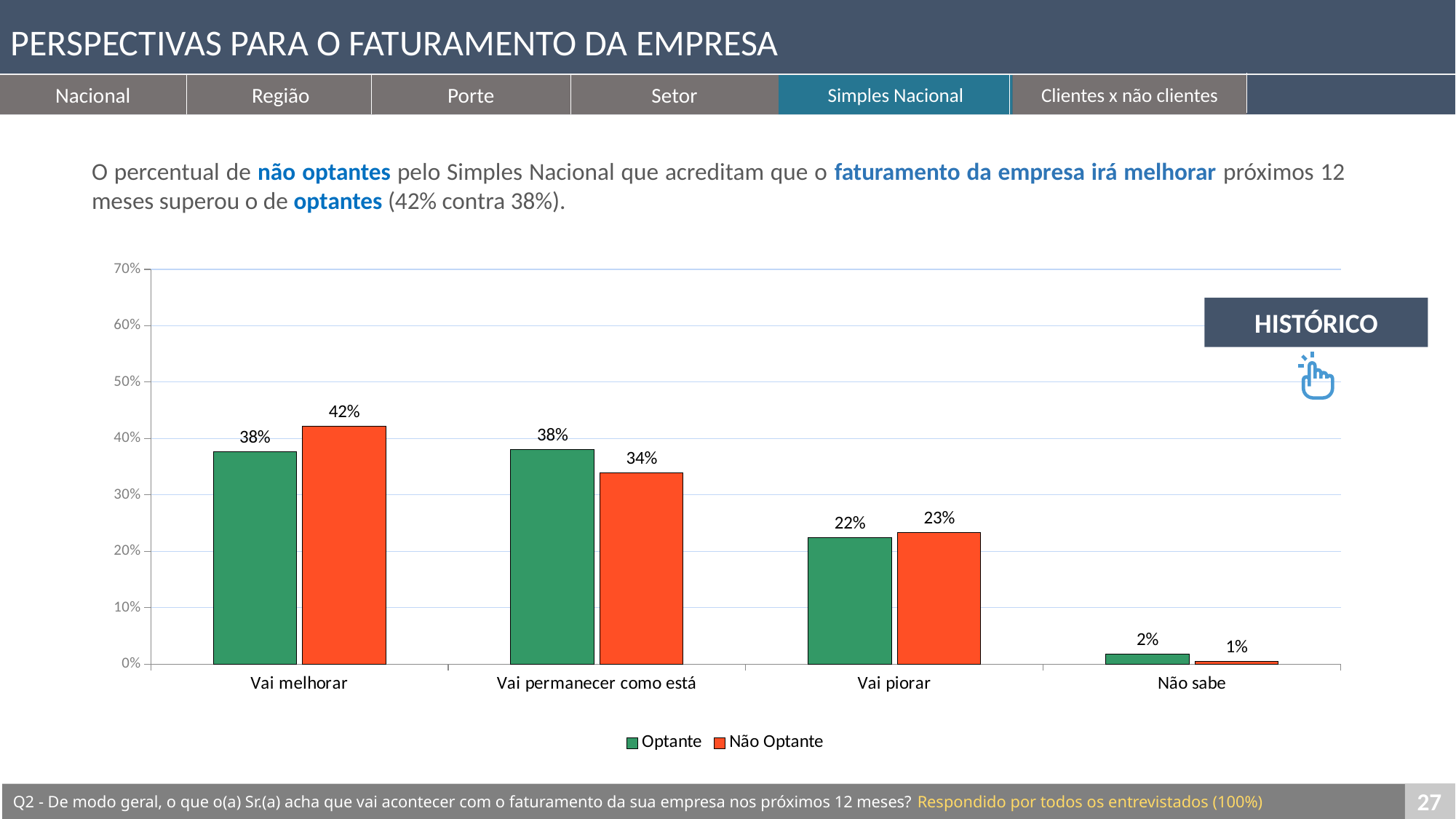
What is the value for Não Optante in the 'Vai piorar' category? 23% What is the value for Optante in the 'Vai permanecer como está' category? 38% How many categories are shown on the x axis of the chart? 4 What is the difference between the Optante and Não Optante values in the 'Vai permanecer como está' category? 4% Which category has the highest value for the Não Optante series? Vai melhorar How many series does the chart legend list? 2 What kind of chart is shown on the slide? bar chart Is the value for Optante in the 'Vai piorar' category greater or less than 30%? less In the 'Vai melhorar' category, which series has the larger value, Optante or Não Optante? Não Optante What is the value for Optante in the 'Não sabe' category? 2% What is the value for Não Optante in the 'Vai melhorar' category? 42% Which category has the lowest value for the Não Optante series? Não sabe